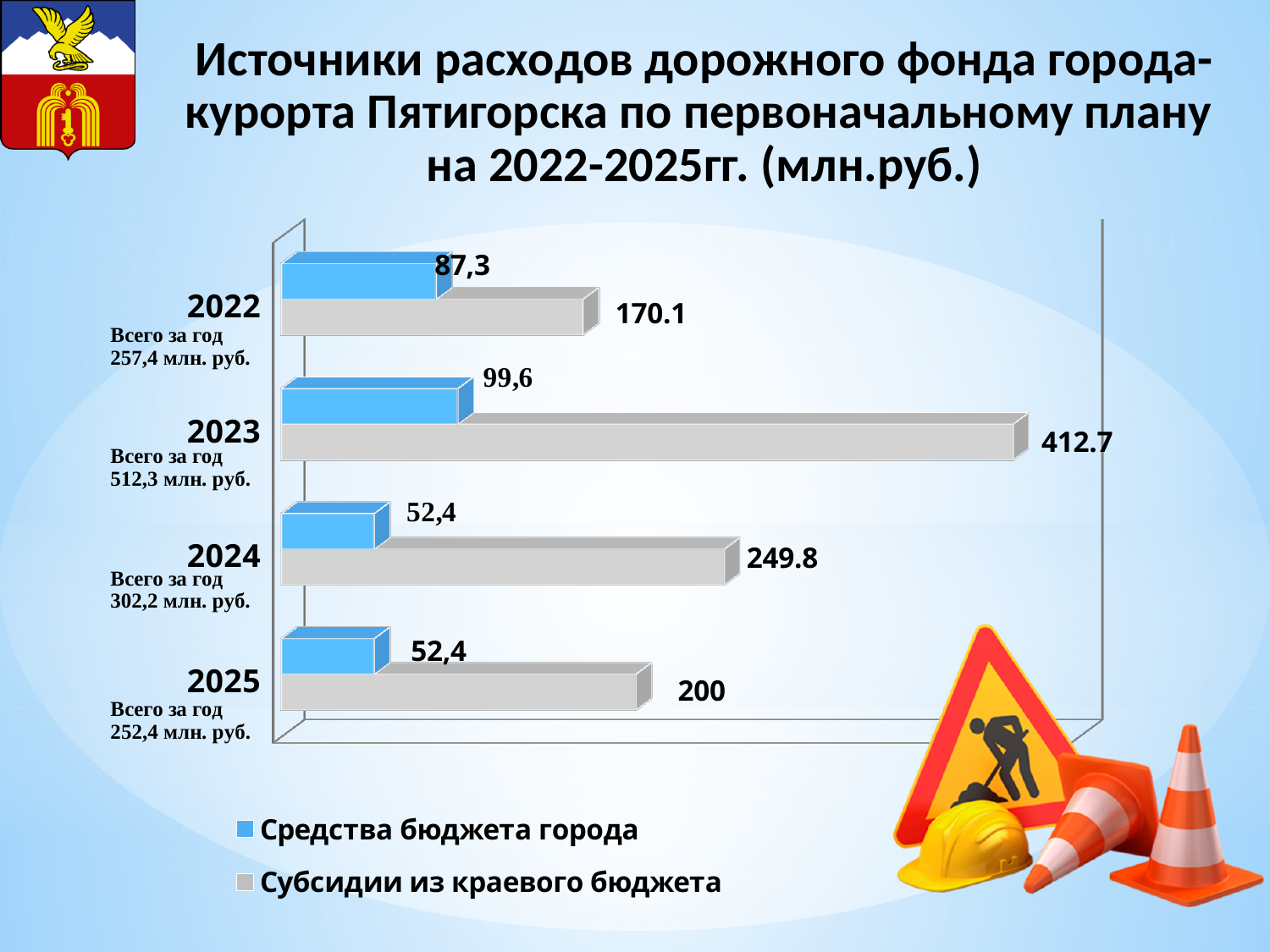
What is the value of Субсидии из краевого бюджета for 2025? 200 What is the difference between Субсидии из краевого бюджета in 2023 and in 2025? 212.7 What is the total for 2023 as printed on the slide (Всего за год)? 512,3 млн. руб. Which is larger for 2024: Средства бюджета города or Субсидии из краевого бюджета? Субсидии из краевого бюджета In which year is Субсидии из краевого бюджета the lowest? 2022 In which year is Субсидии из краевого бюджета the highest? 2023 How many series does the legend list? 2 What is the value of Субсидии из краевого бюджета for 2023? 412.7 In which year is Средства бюджета города the highest? 2023 What is the value of Средства бюджета города for 2022? 87,3 What type of chart is shown on the slide? bar chart How many years (categories) are shown on the chart? 4